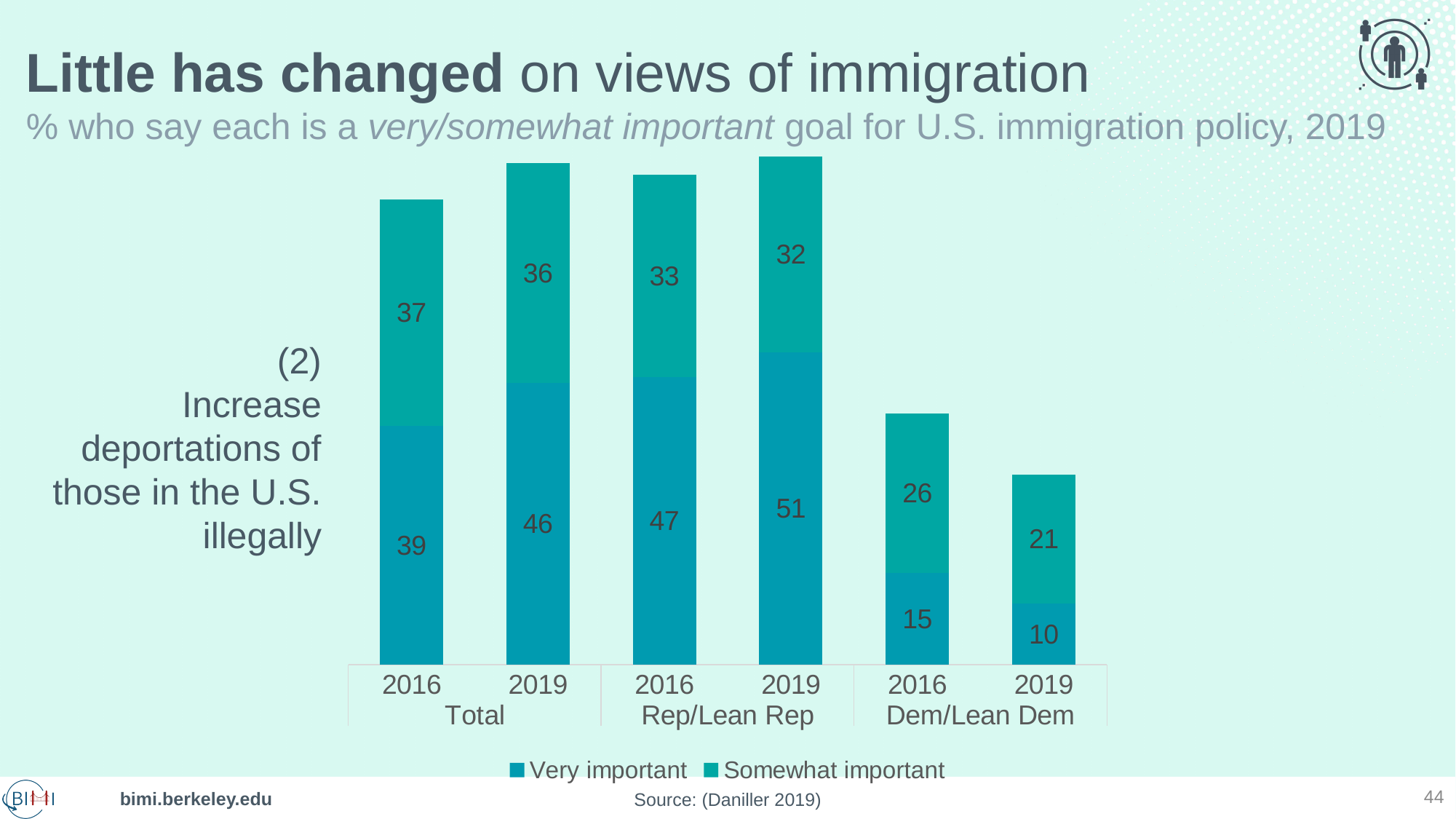
What is the 'Very important' value for Dem/Lean Dem in 2019? 10 What is the total of the stacked bar for Total in 2019? 82 What is the difference between the 'Very important' values for Rep/Lean Rep in 2019 and Dem/Lean Dem in 2019? 41 Which bar has the highest 'Very important' value? Rep/Lean Rep 2019 Which bar has the lowest 'Very important' value? Dem/Lean Dem 2019 What is the total of the stacked bar for Dem/Lean Dem in 2016? 41 What is the 'Somewhat important' value for Rep/Lean Rep in 2019? 32 What is the 'Very important' value for Total in 2016? 39 Is the 'Very important' value for Total in 2019 larger than the 'Very important' value for Total in 2016? Yes What kind of chart is shown on the slide? Stacked bar chart How many stacked bars are shown in the chart? 6 How many series does the legend list? 2